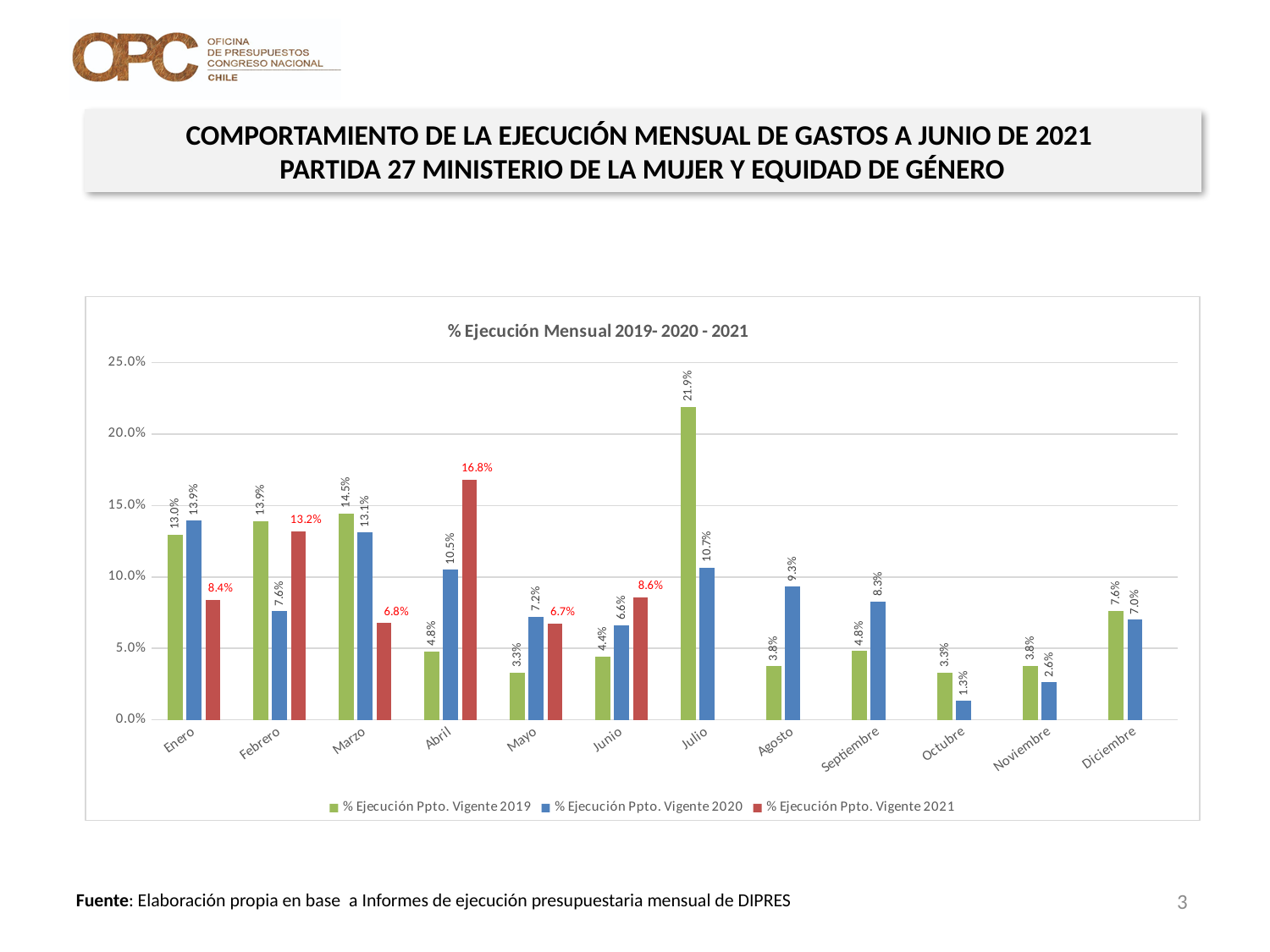
Which month has the highest value in the % Ejecución Ppto. Vigente 2019 series? Julio What is the difference between the 2019 and 2020 values for Marzo? 1.4% How many series does the legend list? 3 What kind of chart is shown on the slide? Bar chart Which month has the lowest value in the % Ejecución Ppto. Vigente 2020 series? Octubre How many months are shown on the x axis? 12 Which is larger for Febrero: the 2020 value or the 2021 value? 2021 value (13.2%) What is the value for Julio in the % Ejecución Ppto. Vigente 2019 series? 21.9% What is the title of the chart? % Ejecución Mensual 2019- 2020 - 2021 What is the value for Abril in the % Ejecución Ppto. Vigente 2021 series? 16.8% What is the value for Octubre in the % Ejecución Ppto. Vigente 2020 series? 1.3% Which month has the highest value in the % Ejecución Ppto. Vigente 2021 series? Abril